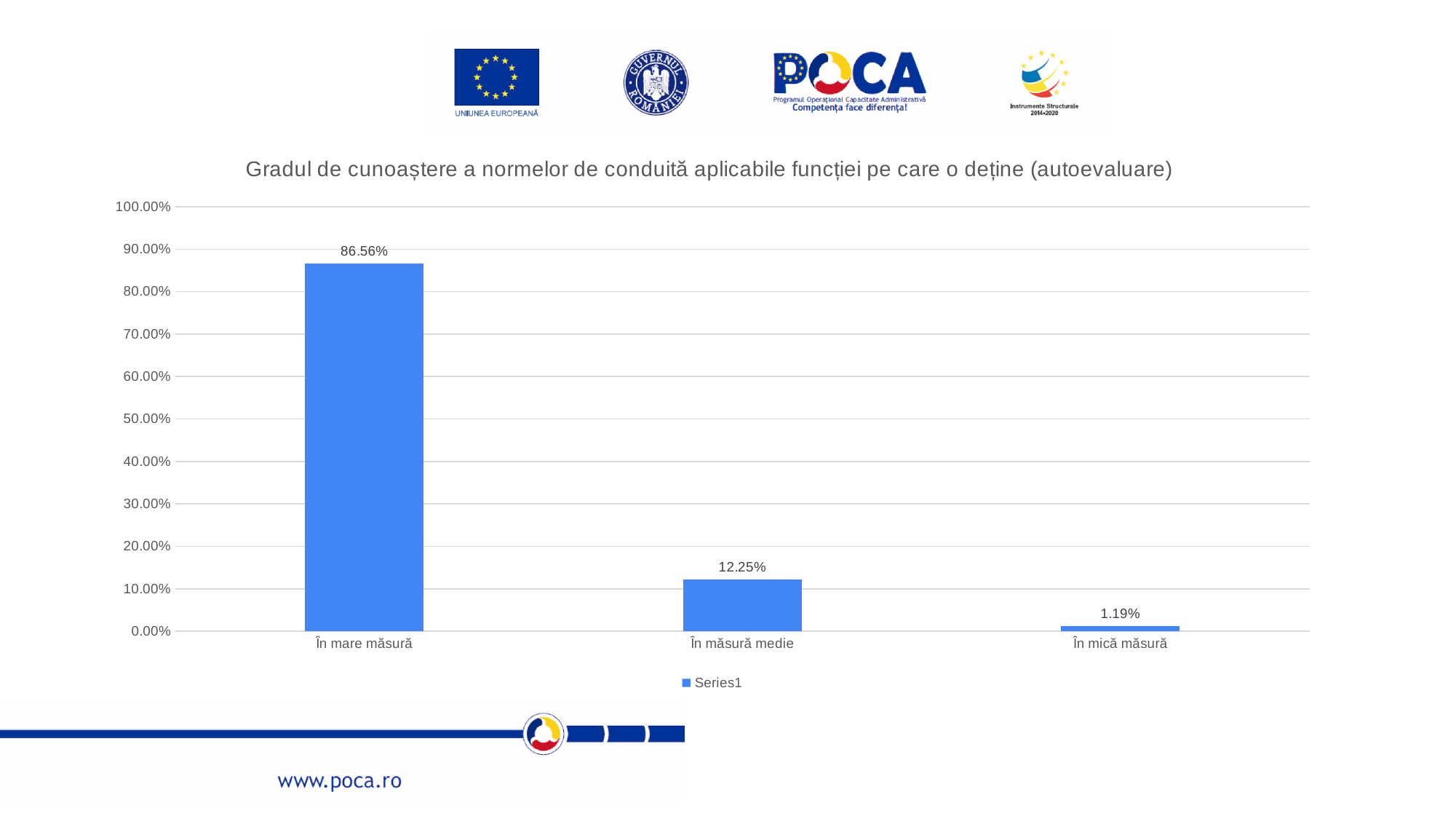
What is the title of the chart? Gradul de cunoaștere a normelor de conduită aplicabile funcției pe care o deține (autoevaluare) Which category has the lowest value? În mică măsură What is the value for "În măsură medie"? 12.25% Which is larger, the value for "În măsură medie" or the value for "În mică măsură"? În măsură medie Which category has the highest value? În mare măsură What is the difference between the values for "În mare măsură" and "În măsură medie"? 74.31% Is the value for "În mare măsură" greater or less than 80.00%? greater What is the difference between the values for "În măsură medie" and "În mică măsură"? 11.06% What kind of chart is shown on the slide? bar chart How many categories are shown on the x axis? 3 What is the value for "În mică măsură"? 1.19% What is the value for "În mare măsură"? 86.56%